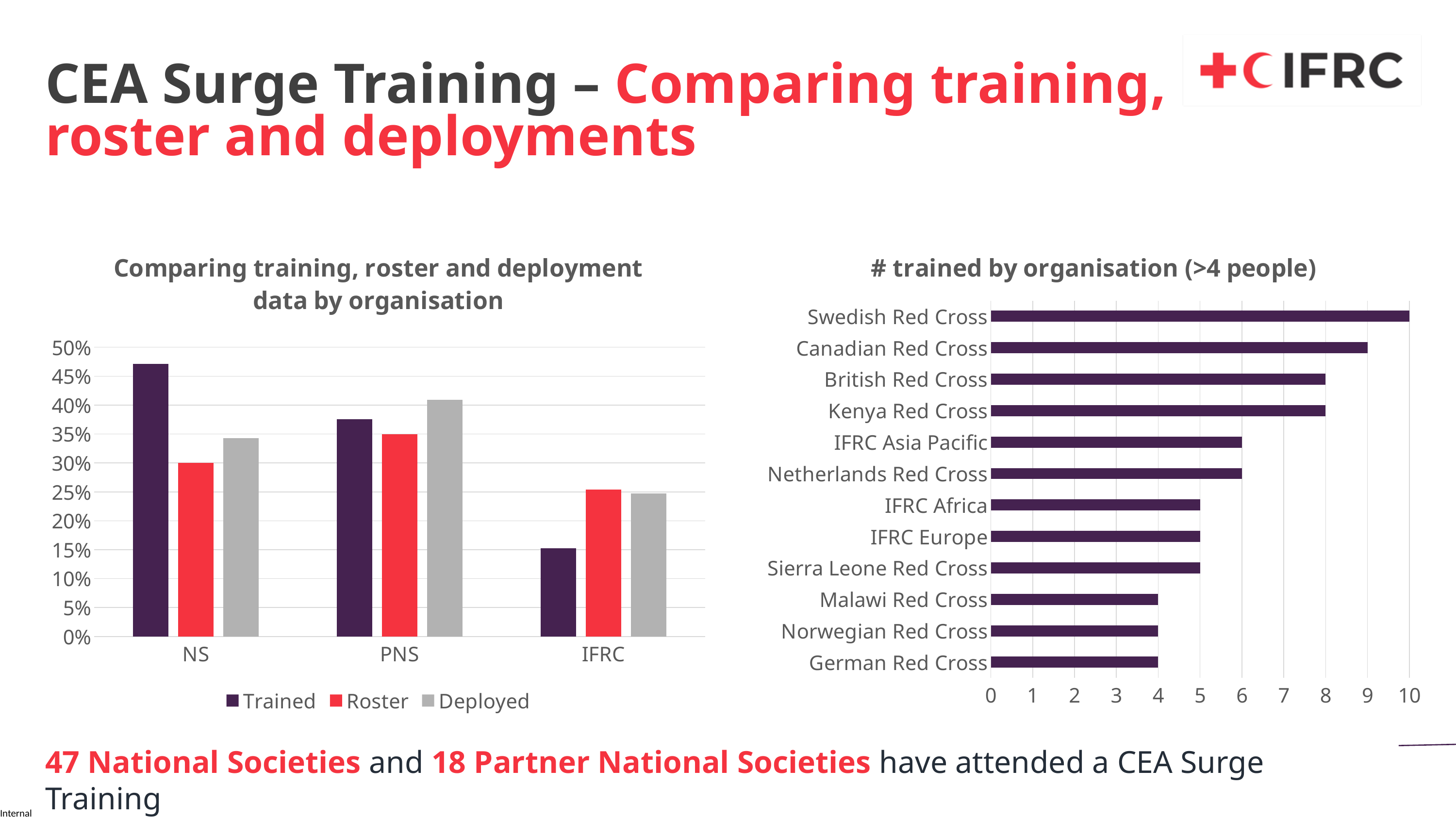
In the '# trained by organisation (>4 people)' chart, which is larger, the value for the British Red Cross or the value for IFRC Africa? British Red Cross In the '# trained by organisation (>4 people)' chart, how many people were trained by the Swedish Red Cross? 10 In the 'Comparing training, roster and deployment data by organisation' chart, which organisation has the highest Trained value? NS In the '# trained by organisation (>4 people)' chart, how many organisations are listed? 12 In the 'Comparing training, roster and deployment data by organisation' chart, how many series does the legend list? 3 In the 'Comparing training, roster and deployment data by organisation' chart, is the Trained value for IFRC greater or less than 20%? less In the '# trained by organisation (>4 people)' chart, how many people were trained by the Canadian Red Cross? 9 In the '# trained by organisation (>4 people)' chart, what is the difference between the Swedish Red Cross and the German Red Cross? 6 In the '# trained by organisation (>4 people)' chart, which organisation has the highest number trained? Swedish Red Cross In the 'Comparing training, roster and deployment data by organisation' chart, which is larger for NS, the Trained value or the Roster value? Trained In the '# trained by organisation (>4 people)' chart, what kind of chart is shown? Bar chart In the 'Comparing training, roster and deployment data by organisation' chart, is the Trained value for NS greater or less than 40%? greater